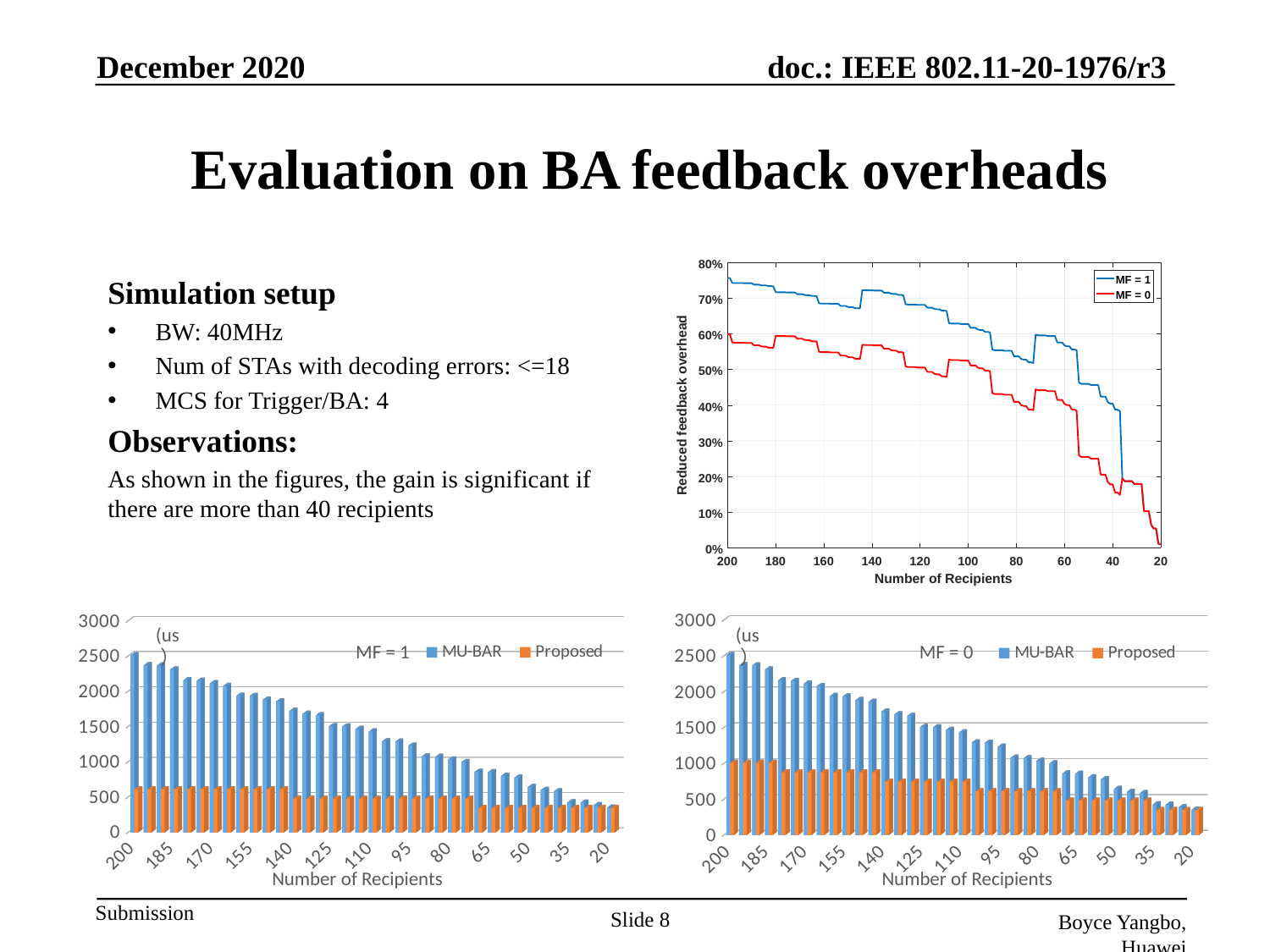
What kind of chart is the bottom-left chart labelled 'MF = 1'? bar chart In the bottom-left 'MF = 1' bar chart, is the Proposed value at 200 recipients greater or less than 1000? less In the bottom-right 'MF = 0' bar chart, do the MU-BAR values rise or fall moving along the x axis from 200 recipients to 20 recipients? fall In the bottom-left 'MF = 1' bar chart, is the MU-BAR value at 200 recipients greater or less than 2000? greater In the top-right line chart, is the value for MF = 0 at 200 recipients greater or less than 50%? greater What are the two legend entries of the bottom-right 'MF = 0' bar chart? MU-BAR and Proposed In the top-right line chart, do the values rise or fall moving along the x axis from 200 recipients to 20 recipients? fall What kind of chart is the top-right chart titled with the y-axis 'Reduced feedback overhead'? line chart In the top-right line chart, which series has the larger value at 200 recipients, MF = 1 or MF = 0? MF = 1 How many series does the legend of the top-right line chart list? 2 In the bottom-right 'MF = 0' bar chart, which series has the larger value at 200 recipients, MU-BAR or Proposed? MU-BAR